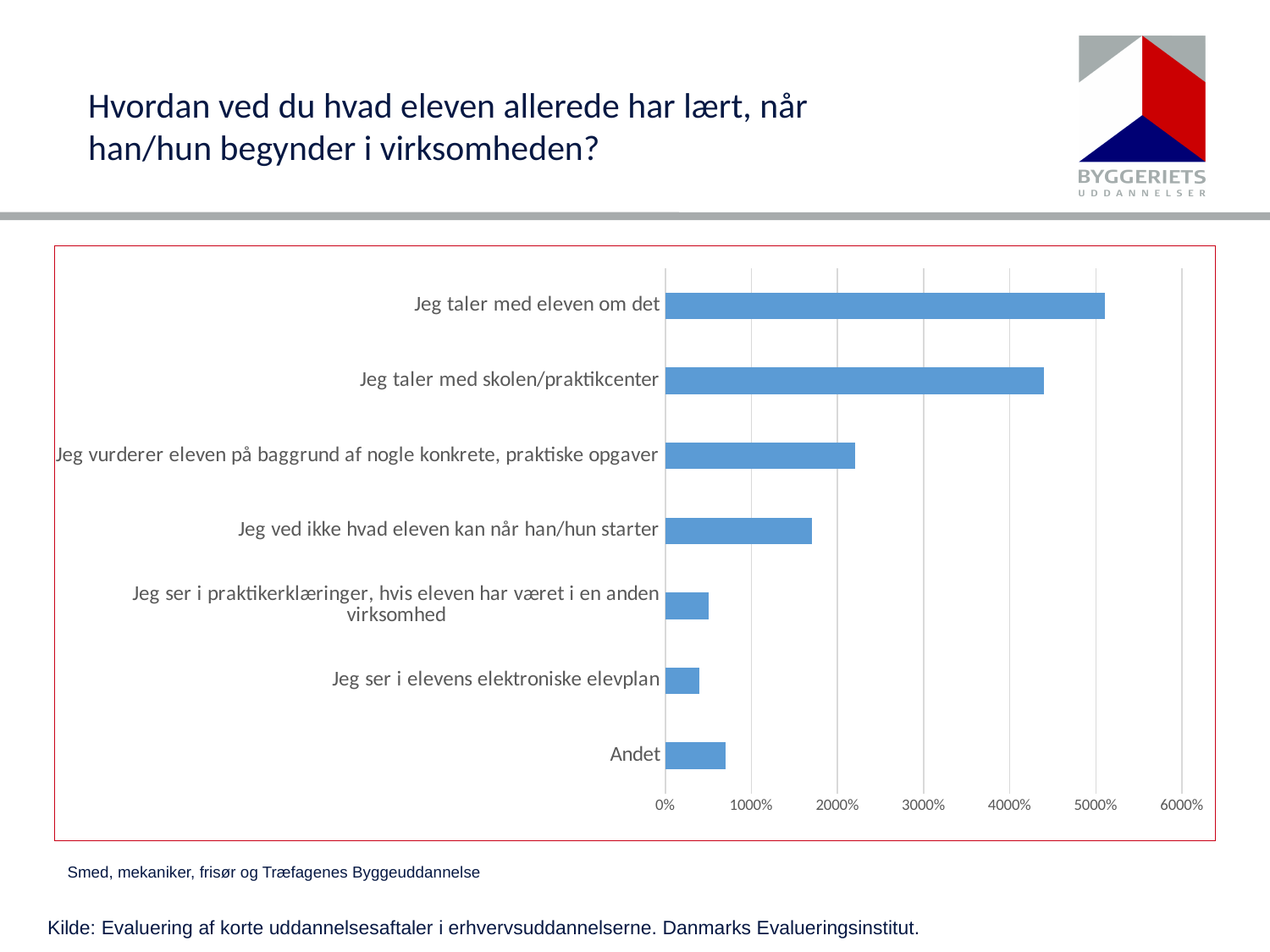
What kind of chart is shown on the slide? bar chart Is the value for "Jeg taler med skolen/praktikcenter" greater or less than 5000%? less Which category has the highest value in the chart? Jeg taler med eleven om det How many categories are plotted in the chart? 7 Is the value for "Andet" greater or less than 1000%? less Is the value for "Jeg vurderer eleven på baggrund af nogle konkrete, praktiske opgaver" greater or less than 3000%? less What is the highest value shown on the horizontal axis of the chart? 6000% Which is larger: the value for "Jeg vurderer eleven på baggrund af nogle konkrete, praktiske opgaver" or the value for "Jeg ved ikke hvad eleven kan når han/hun starter"? Jeg vurderer eleven på baggrund af nogle konkrete, praktiske opgaver